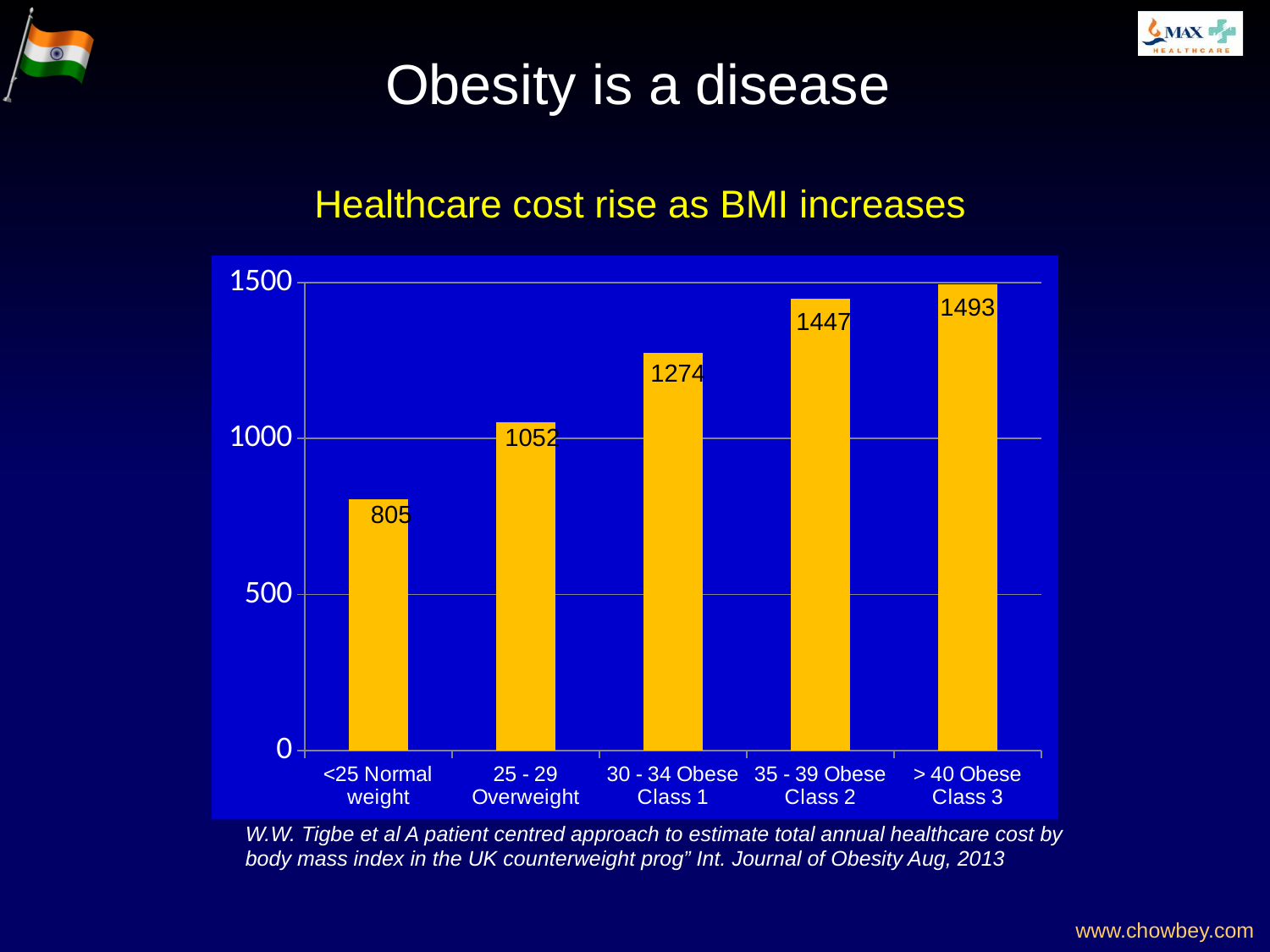
Which is larger, the value for 30 - 34 Obese Class 1 or the value for 25 - 29 Overweight? 30 - 34 Obese Class 1 Is the value for 25 - 29 Overweight greater or less than 1000? greater What is the value shown for the 30 - 34 Obese Class 1 category? 1274 How many BMI categories are shown in the chart? 5 Which BMI category has the lowest value? <25 Normal weight What is the value shown for the 35 - 39 Obese Class 2 category? 1447 What kind of chart is shown on the slide? Bar chart Do the values rise or fall as BMI category increases along the x axis? Rise What is the healthcare cost value for the <25 Normal weight category? 805 Which BMI category has the highest value? > 40 Obese Class 3 What is the difference between the values for > 40 Obese Class 3 and <25 Normal weight? 688 What is the difference between the values for 25 - 29 Overweight and <25 Normal weight? 247